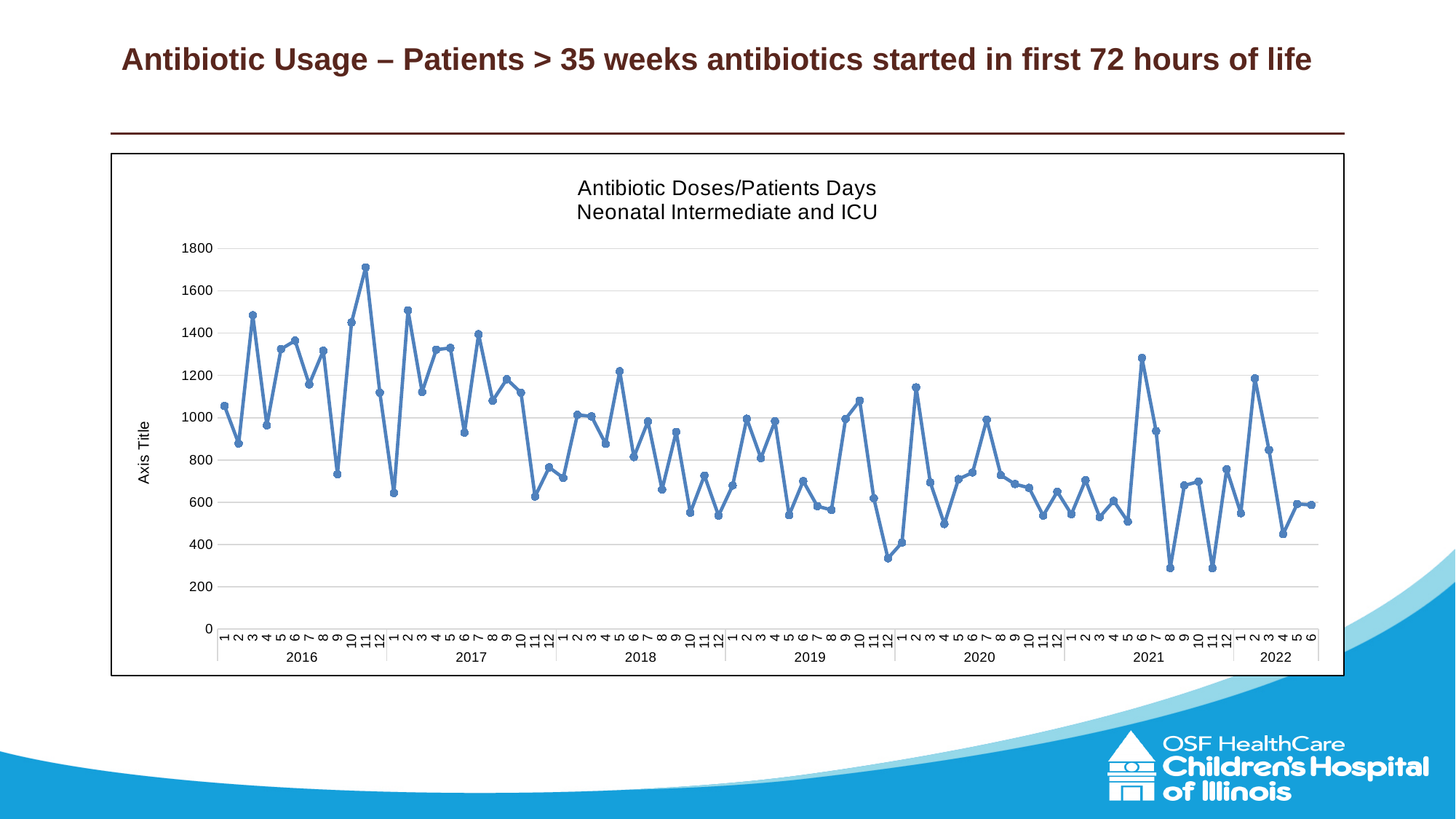
Is the value for month 11 of 2016 greater or less than 1600? greater How many monthly data points are plotted on the chart? 78 Is the value for month 12 of 2019 greater or less than 400? less Which is larger, the value for month 11 of 2016 or the value for month 2 of 2017? Month 11 of 2016 What label is shown on the vertical axis of the chart? Axis Title Is the value for month 2 of 2017 greater or less than 1400? greater Overall, do the values rise or fall from 2016 to 2022? Fall What is the title of the chart? Antibiotic Doses/Patients Days Neonatal Intermediate and ICU What kind of chart is shown on the slide? Line chart In which year and month does the chart reach its highest value? 2016, month 11